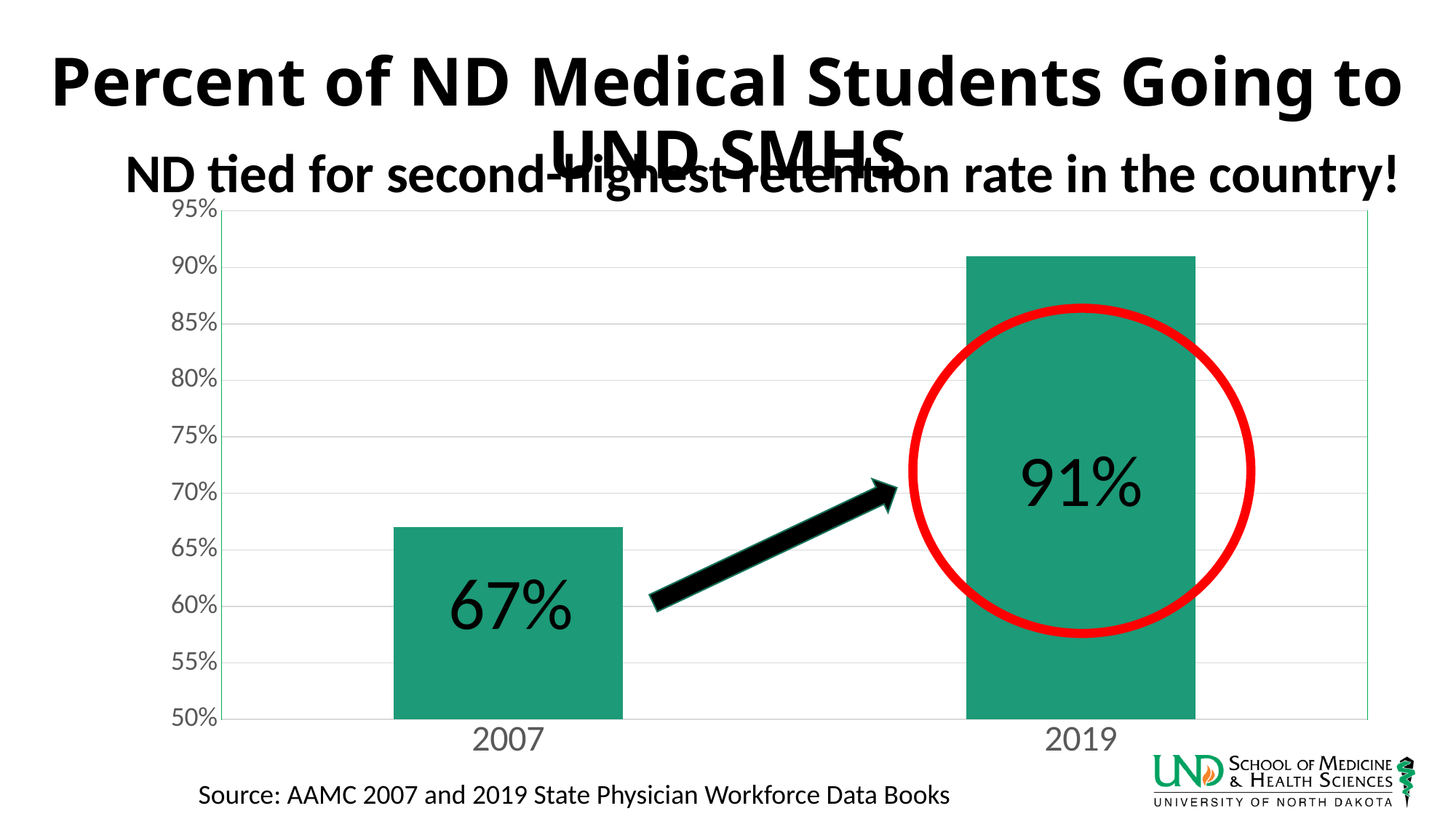
Is the value for 2007 greater or less than 70%? less How many bars are shown in the chart? 2 Do the values rise or fall from 2007 to 2019? rise What kind of chart is shown on the slide? bar chart What is the lowest value shown on the vertical axis? 50% Is the value for 2019 greater or less than 90%? greater What is the value for 2007? 67% Which year has the higher value? 2019 What colour are the bars in the chart? green What is the difference between the 2019 value and the 2007 value? 24% Which year has the lower value? 2007 What is the value for 2019? 91%